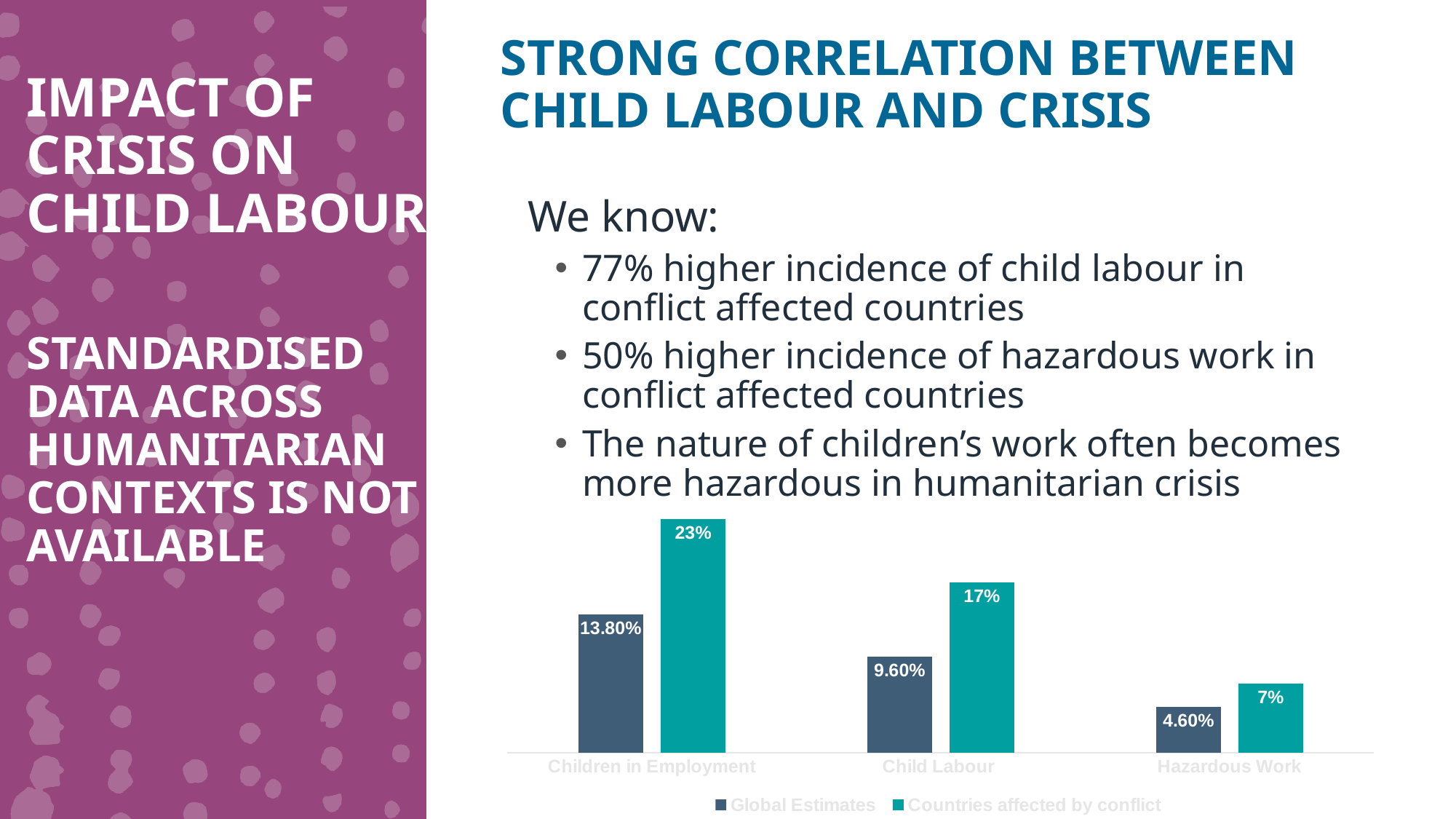
What is the Global Estimates value for Hazardous Work? 4.60% What is the difference between the Countries affected by conflict value and the Global Estimates value for Child Labour? 7.40% Which category has the lowest Global Estimates value? Hazardous Work Which category has the highest Countries affected by conflict value? Children in Employment How many categories are shown on the x axis of the chart? 3 What is the Global Estimates value for Children in Employment? 13.80% Which colour represents the Countries affected by conflict series in the chart? Teal For Hazardous Work, which series has the larger value: Global Estimates or Countries affected by conflict? Countries affected by conflict What kind of chart is shown on the slide? Bar chart What is the Countries affected by conflict value for Child Labour? 17% What is the Countries affected by conflict value for Children in Employment? 23% How many series does the chart legend list? 2